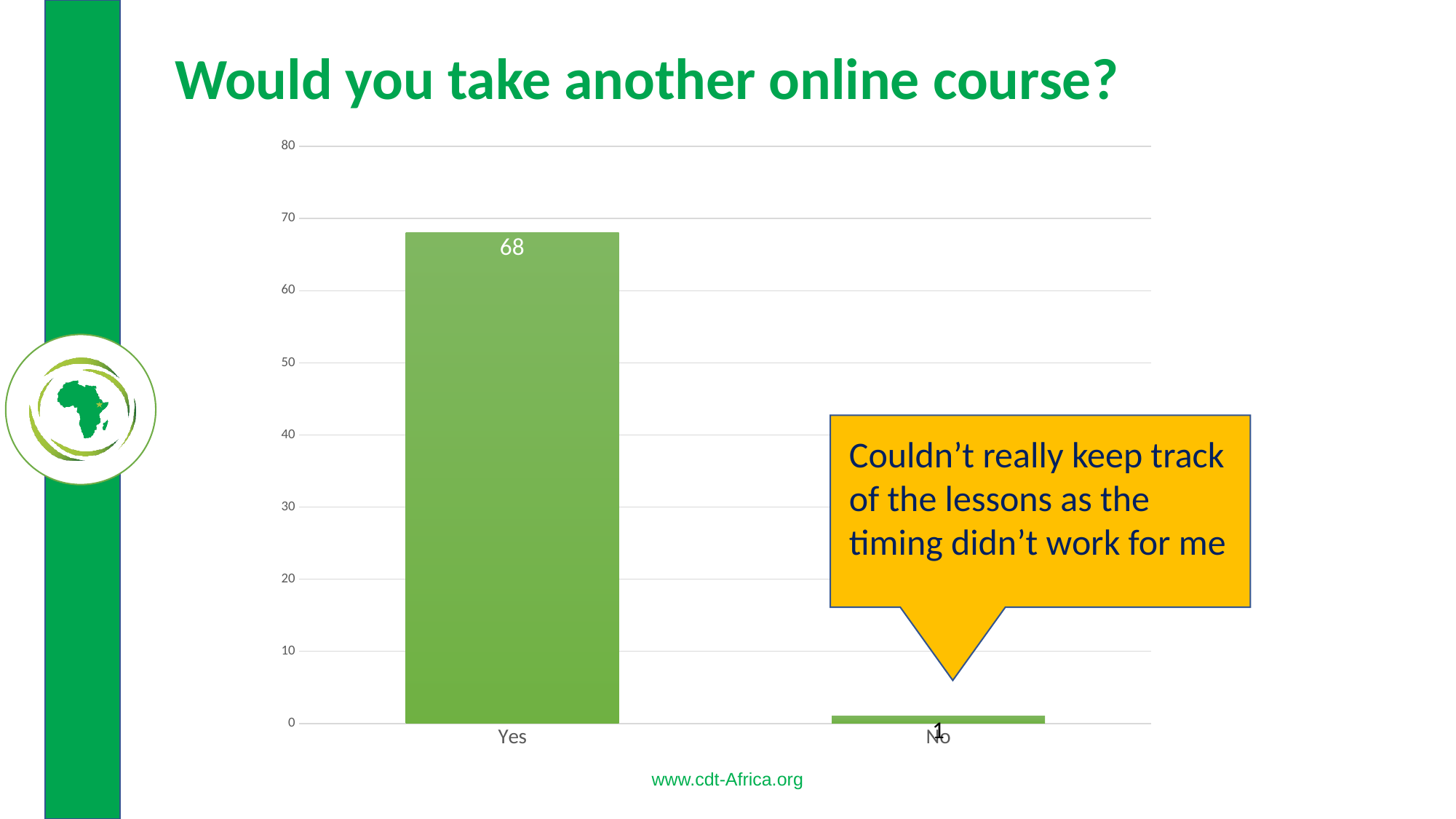
What is the highest value shown on the y axis? 80 Which is larger, the value for Yes or the value for No? Yes How many categories are shown on the x axis? 2 What kind of chart is shown on the slide? bar chart Which category has the highest value? Yes Is the value for Yes greater or less than 60? greater Is the value for No greater or less than 10? less Which category has the lowest value? No What is the title of the slide above the chart? Would you take another online course? What is the value for No? 1 What is the difference between the values for Yes and No? 67 What is the value for Yes? 68